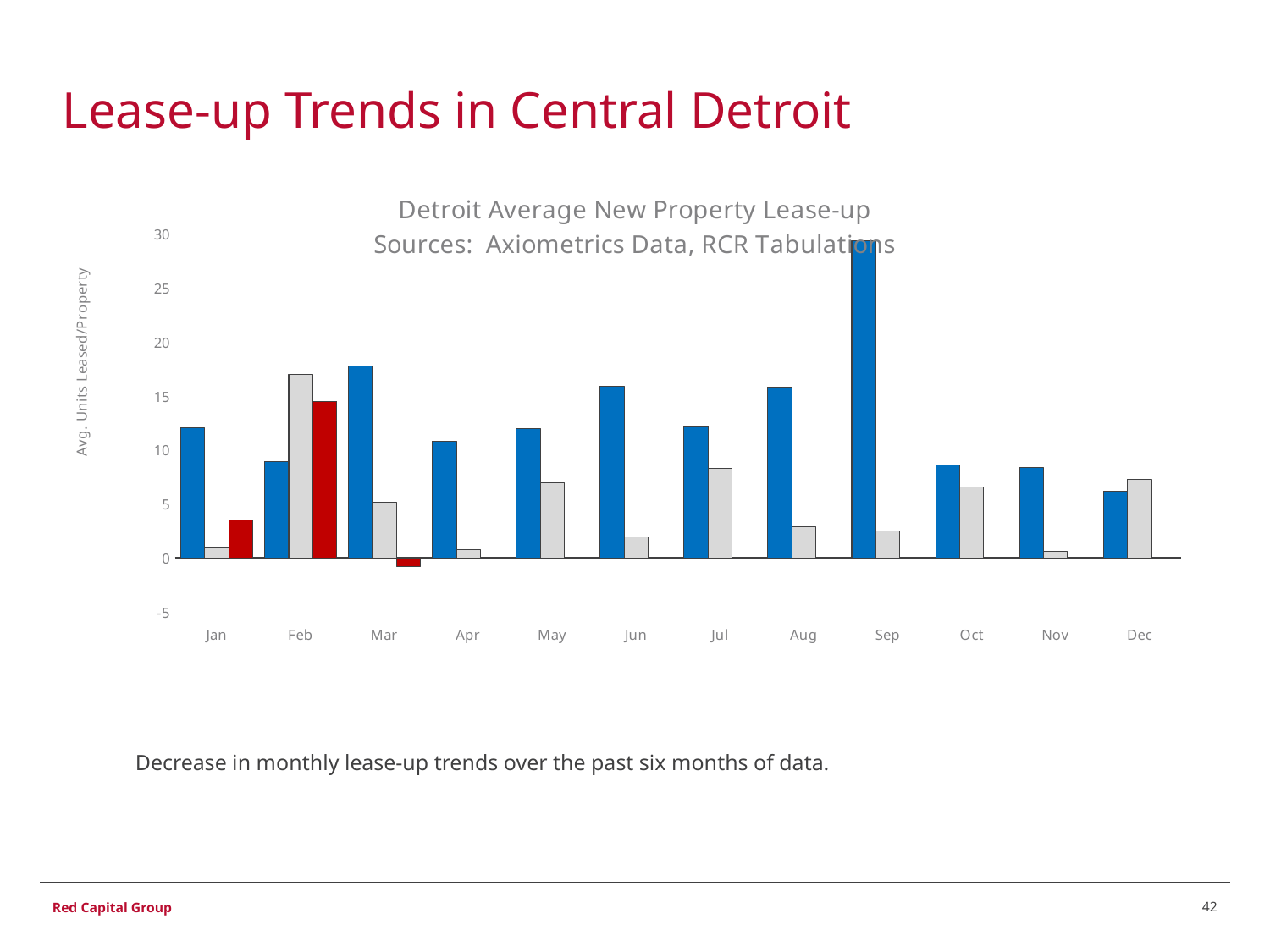
Is the value of the blue bar for Sep greater or less than 25? greater What kind of chart is shown on the slide? bar chart Is the value of the blue bar for Jan greater or less than 10? greater Which month has the tallest blue bar? Sep Which month has the shortest blue bar? Dec In Feb, which is larger, the blue bar or the grey bar? the grey bar Is the value of the red bar for Mar greater or less than 0? less What is the label on the vertical axis of the chart? Avg. Units Leased/Property How many months are shown on the x axis of the chart? 12 What is the title of the chart? Detroit Average New Property Lease-up Sources: Axiometrics Data, RCR Tabulations